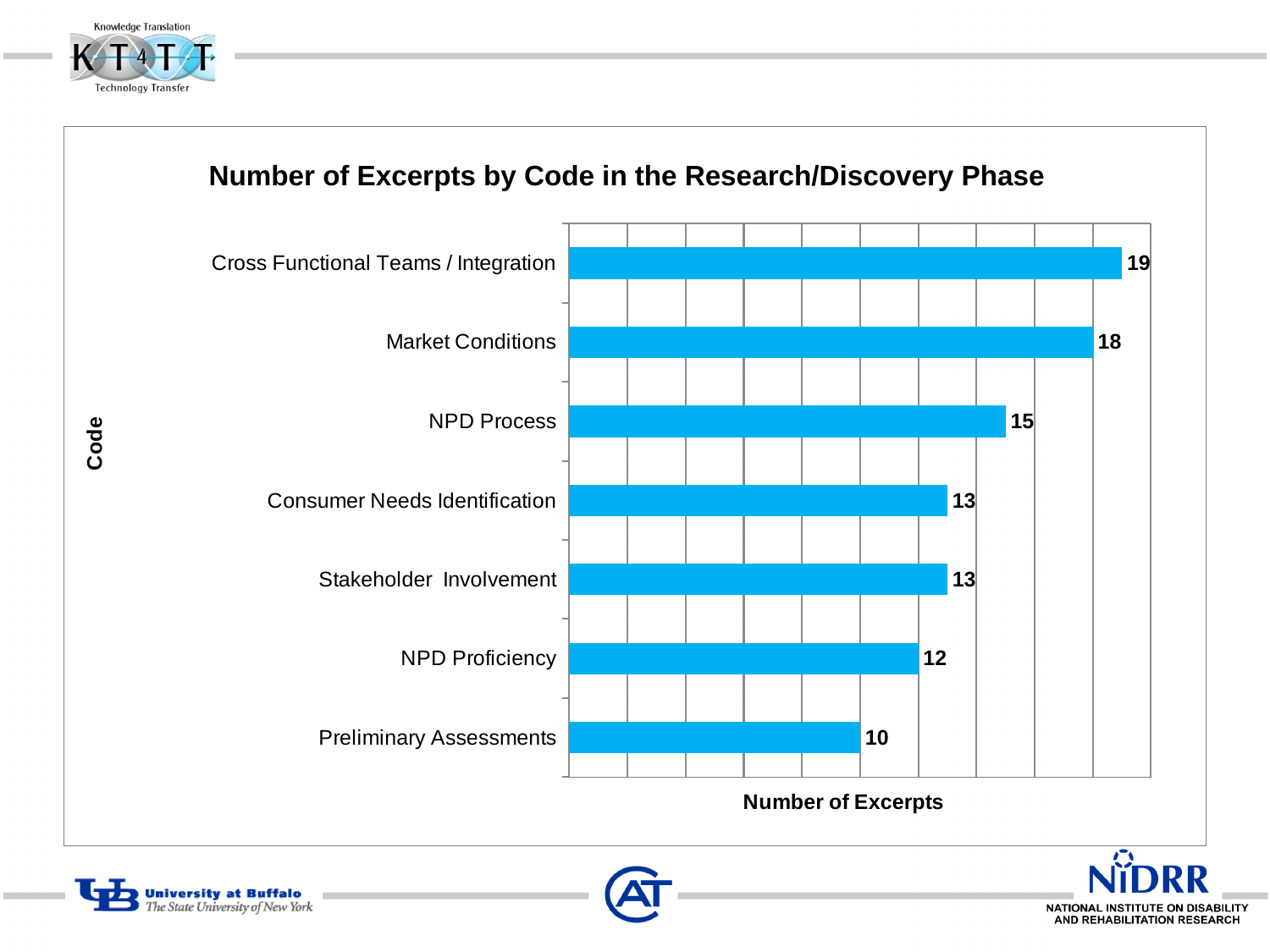
How many codes are shown in the chart? 7 What is the title of the chart? Number of Excerpts by Code in the Research/Discovery Phase What is the number of excerpts for Preliminary Assessments? 10 Which code has the lowest number of excerpts? Preliminary Assessments Which code has the highest number of excerpts? Cross Functional Teams / Integration Which has more excerpts, Market Conditions or Consumer Needs Identification? Market Conditions What is the number of excerpts for NPD Proficiency? 12 What is the difference in number of excerpts between Stakeholder Involvement and Preliminary Assessments? 3 What is the label of the horizontal axis? Number of Excerpts What is the difference in number of excerpts between Cross Functional Teams / Integration and NPD Process? 4 What kind of chart is shown on the slide? Bar chart What is the number of excerpts for Market Conditions? 18